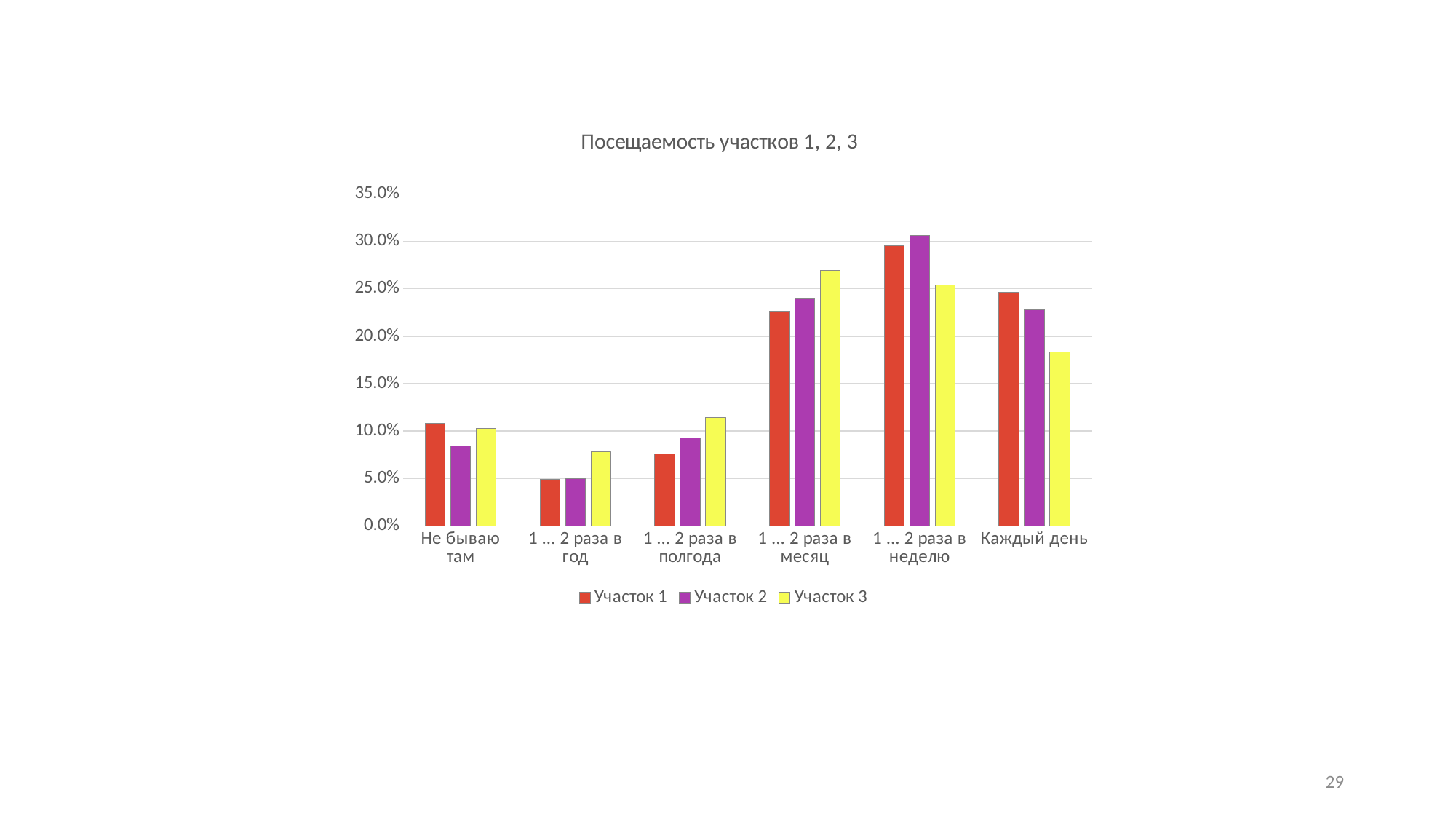
How many categories are shown on the x axis? 6 Is the value for Участок 3 in the category Каждый день greater or less than 20.0%? less For which category is the value for Участок 1 the highest? 1 … 2 раза в неделю In the category Каждый день, which is larger: Участок 1 or Участок 3? Участок 1 Is the value for Участок 1 in the category 1 … 2 раза в неделю greater or less than 25.0%? greater Which colour represents Участок 3 in the chart? Yellow How many series does the legend list? 3 In the category 1 … 2 раза в год, which is larger: Участок 1 or Участок 3? Участок 3 What is the title of the chart? Посещаемость участков 1, 2, 3 For which category is the value for Участок 3 the highest? 1 … 2 раза в месяц For which category is the value for Участок 1 the lowest? 1 … 2 раза в год What kind of chart is shown on the slide? Bar chart